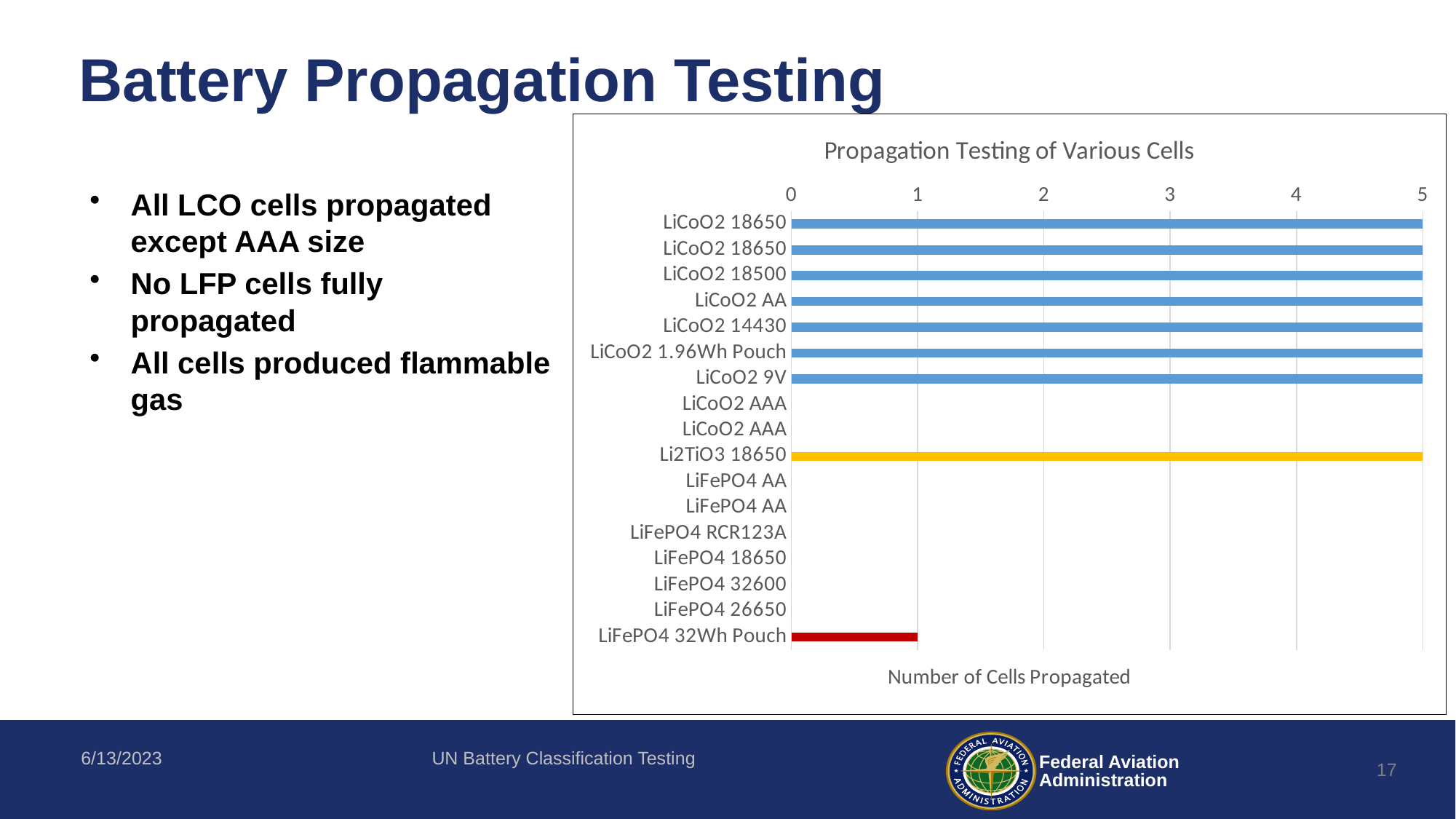
Which LiFePO4 cell type had the highest number of cells propagated? LiFePO4 32Wh Pouch What is the title of the chart? Propagation Testing of Various Cells What kind of chart is shown on the slide? bar chart What is the difference in number of cells propagated between LiCoO2 9V and LiFePO4 32Wh Pouch? 4 Which had more cells propagated, LiCoO2 14430 or LiFePO4 32Wh Pouch? LiCoO2 14430 How many cells propagated for LiFePO4 32Wh Pouch? 1 How many cell categories are listed on the chart? 17 How many cells propagated for LiFePO4 18650? 0 How many cells propagated for LiCoO2 9V? 5 How many cells propagated for LiCoO2 18500? 5 What is the x-axis title of the chart? Number of Cells Propagated How many cells propagated for Li2TiO3 18650? 5